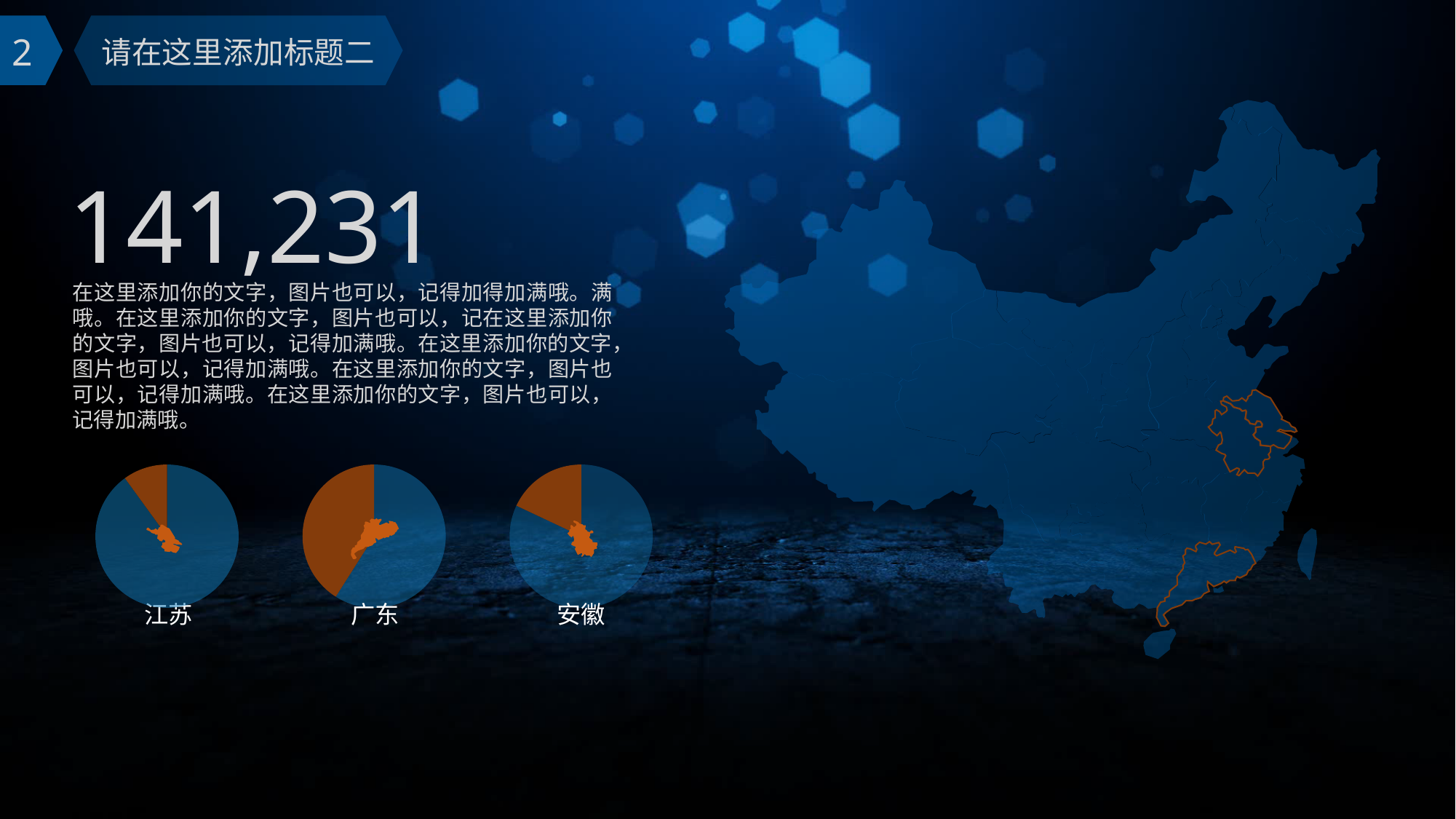
Is the orange slice larger in the 安徽 pie chart or the 江苏 pie chart? 安徽 Which pie chart has the largest orange slice? 广东 What kind of chart is used for 江苏, 广东 and 安徽 on the slide? pie chart Is the orange slice larger in the 广东 pie chart or the 安徽 pie chart? 广东 How many slices does each pie chart have? 2 Which pie chart has the smallest orange slice? 江苏 What is the label under the rightmost pie chart? 安徽 How many pie charts are shown on the slide? 3 What is the label under the leftmost pie chart? 江苏 Is the orange slice larger in the 广东 pie chart or the 江苏 pie chart? 广东